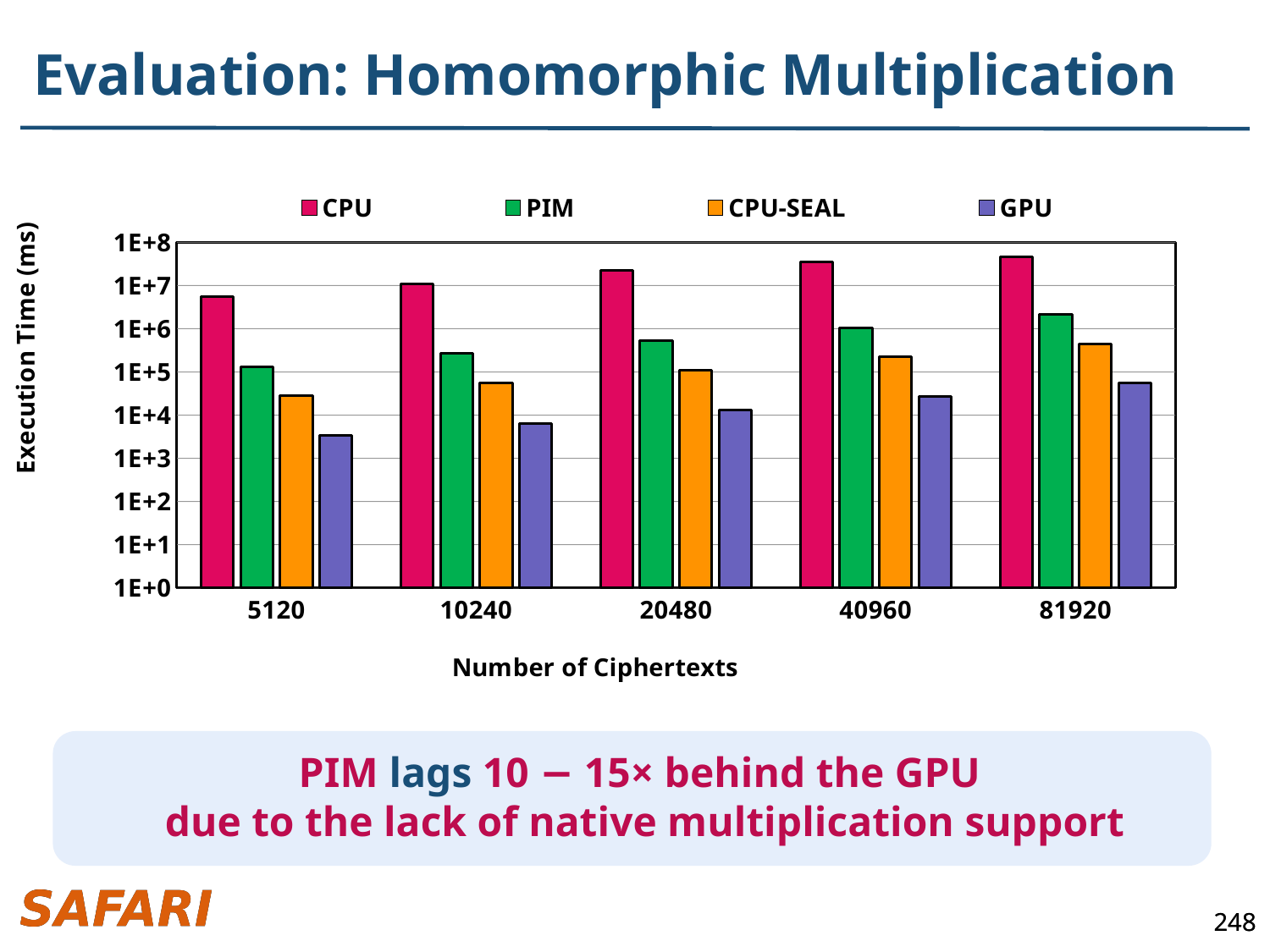
Is the execution time for CPU at 5120 ciphertexts greater or less than 1E+6? greater Is the execution time for PIM at 81920 ciphertexts greater or less than 1E+6? greater Is the execution time for GPU at 5120 ciphertexts greater or less than 1E+4? less How many categories are shown on the x axis (Number of Ciphertexts)? 5 Which series has the highest execution time at 5120 ciphertexts? CPU Which series is shown in orange in the legend? CPU-SEAL Which series has the lowest execution time at 81920 ciphertexts? GPU What is the label of the y axis? Execution Time (ms) Does the CPU execution time rise or fall as the number of ciphertexts increases? rise At 20480 ciphertexts, which has the larger execution time, PIM or CPU-SEAL? PIM What kind of chart is shown on the slide? bar chart How many series does the legend list? 4